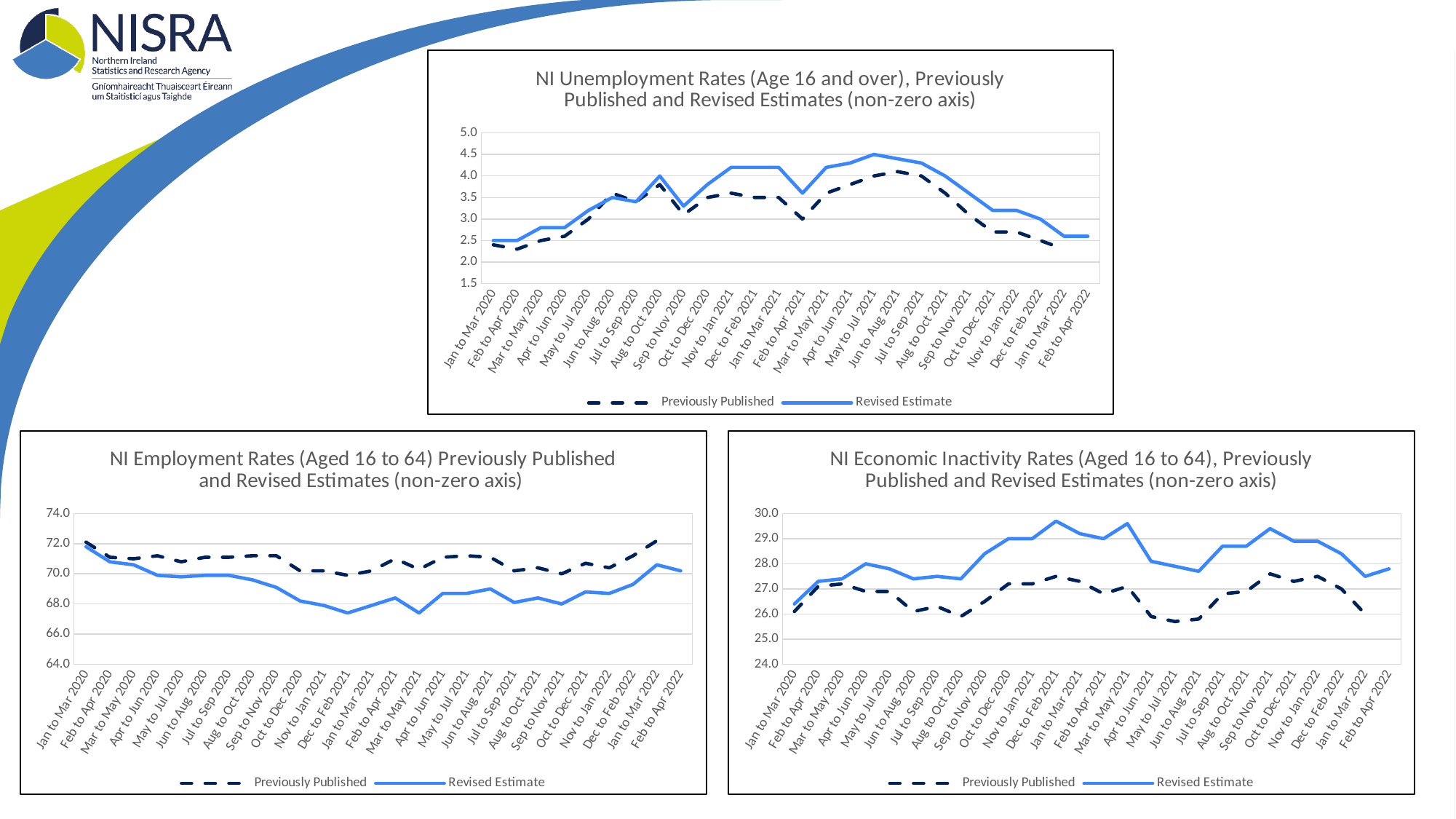
In the NI Economic Inactivity Rates chart, is the Revised Estimate for Dec to Feb 2021 greater or less than 29.0? greater How many time periods are plotted along the x axis of the NI Economic Inactivity Rates chart? 26 In the NI Employment Rates chart, is the Revised Estimate for Dec to Feb 2021 greater or less than 68.0? less In the NI Unemployment Rates chart, is the Revised Estimate for Jun to Aug 2021 greater or less than 4.0? greater In the NI Economic Inactivity Rates chart, which series is shown as a dashed line? Previously Published In the NI Unemployment Rates chart, which period has the highest Revised Estimate? May to Jul 2021 How many series does the legend of the NI Employment Rates chart list? 2 In the NI Unemployment Rates chart, does the Revised Estimate rise or fall from Jun to Aug 2021 to Jan to Mar 2022? fall What kind of chart is the NI Unemployment Rates chart? line chart In the NI Employment Rates chart, which series is larger for Jan to Mar 2021, Previously Published or Revised Estimate? Previously Published